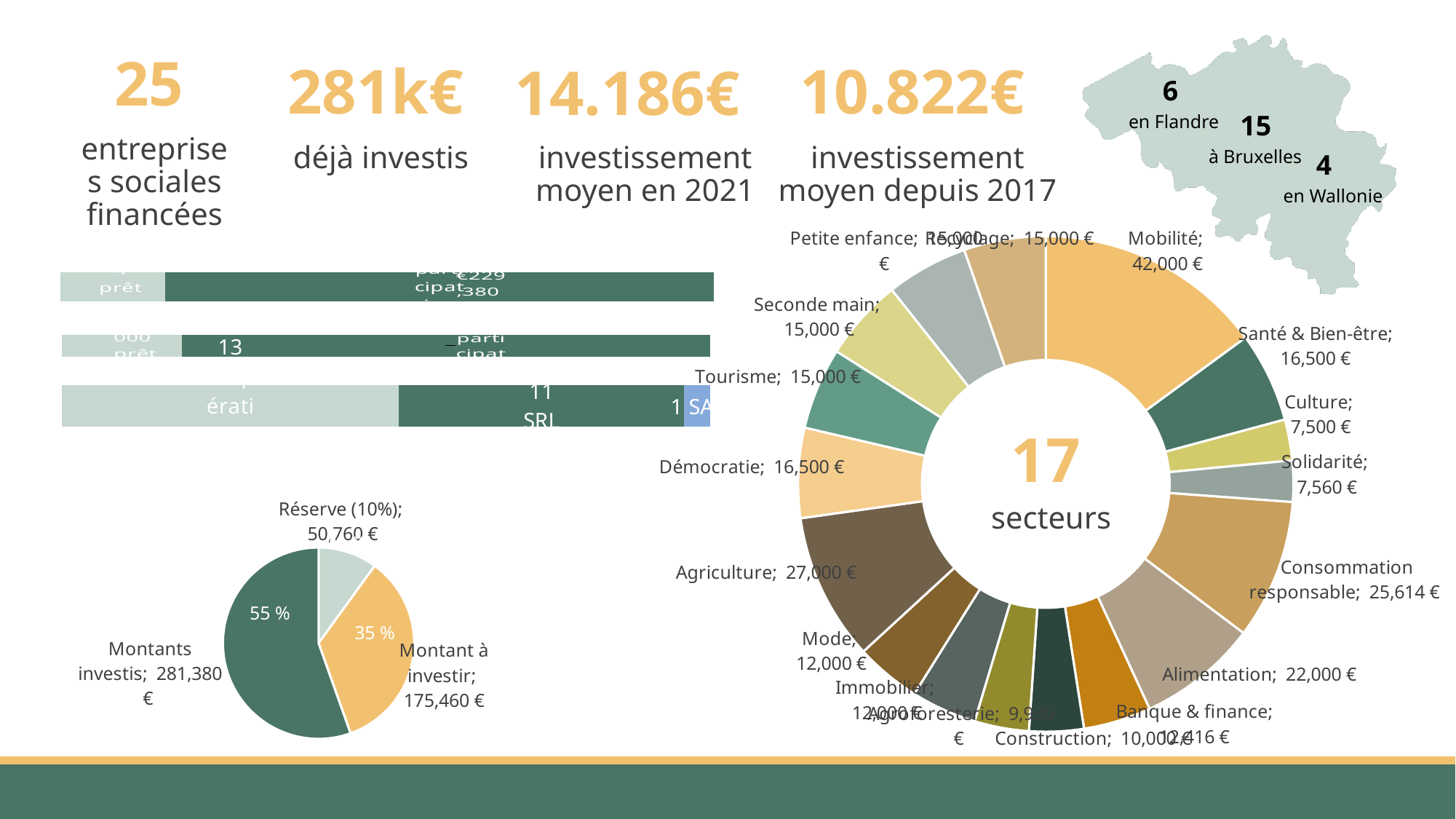
In the pie chart at the bottom left, which slice is the largest? Montants investis In the doughnut chart on the right, what is the value for Culture? 7,500 € In the doughnut chart on the right, which is larger: Santé & Bien-être or Culture? Santé & Bien-être In the pie chart at the bottom left, what share does Montants investis represent? 55 % In the pie chart at the bottom left, what is the value for Montant à investir? 175,460 € In the doughnut chart on the right, what is the value for Consommation responsable? 25,614 € In the pie chart at the bottom left, what is the value for Réserve (10%)? 50,760 € In the doughnut chart on the right, what is the value for Mobilité? 42,000 € What kind of chart is the large chart on the right of the slide? Doughnut chart According to the label in the centre of the doughnut chart on the right, how many sectors are shown? 17 In the doughnut chart on the right, which sector has the highest value? Mobilité In the doughnut chart on the right, what is the difference between the values for Agriculture and Alimentation? 5,000 €